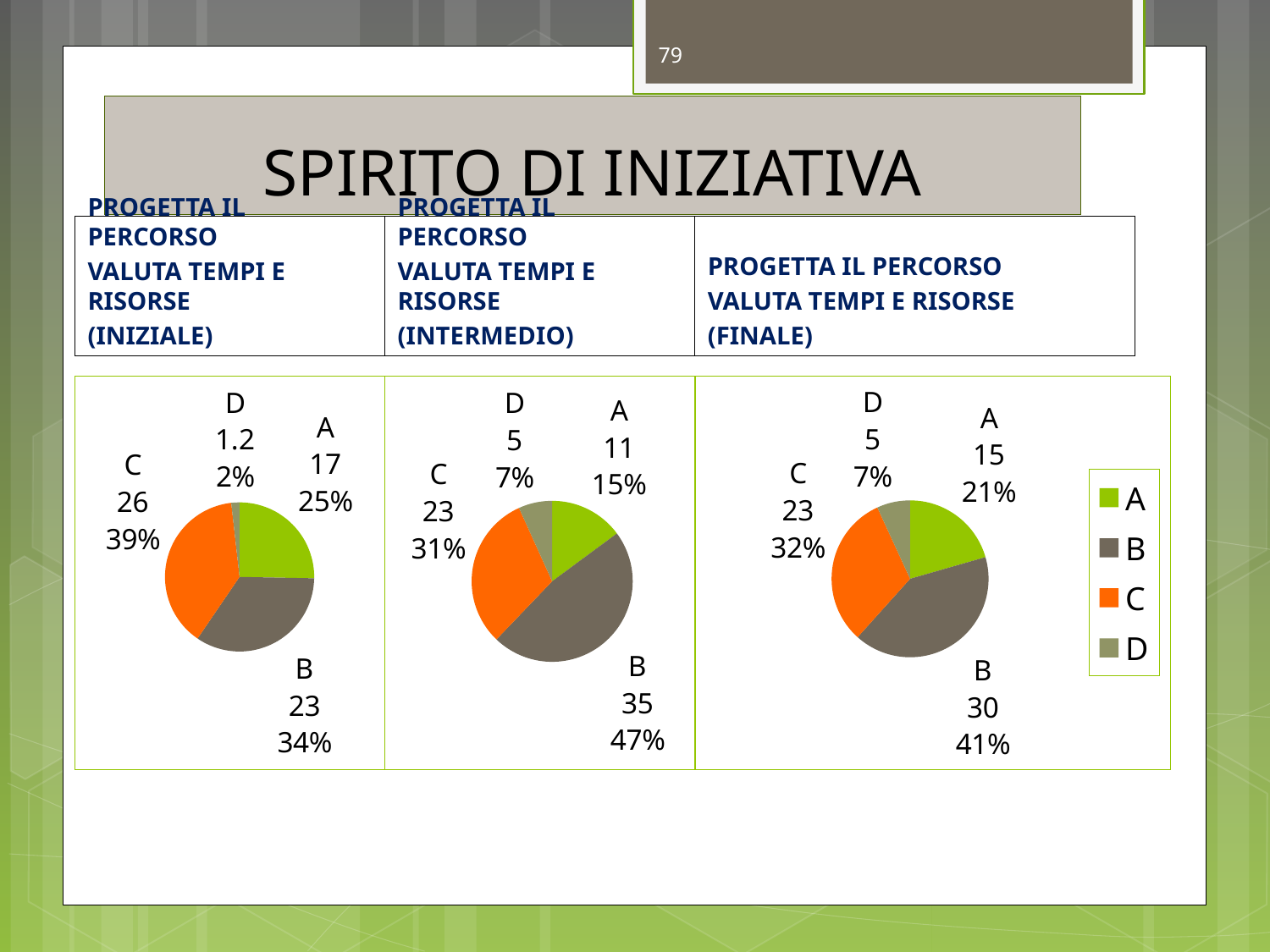
How many entries does the legend on the right list? 4 What kind of chart is used on this slide? Pie chart How many categories does each pie chart show? 4 In the left pie chart (INIZIALE), what value is shown for category C? 26 In the middle pie chart (INTERMEDIO), which is larger, the value for A or the value for C? C In the right pie chart (FINALE), what percentage share does category A have? 21% In the left pie chart (INIZIALE), which category has the largest slice? C In the middle pie chart (INTERMEDIO), what value is shown for category B? 35 In the right pie chart (FINALE), which category has the smallest slice? D In the right pie chart (FINALE), what is the difference between the values for B and C? 7 In the middle pie chart (INTERMEDIO), which category has the largest slice? B In the left pie chart (INIZIALE), what percentage share does category D have? 2%